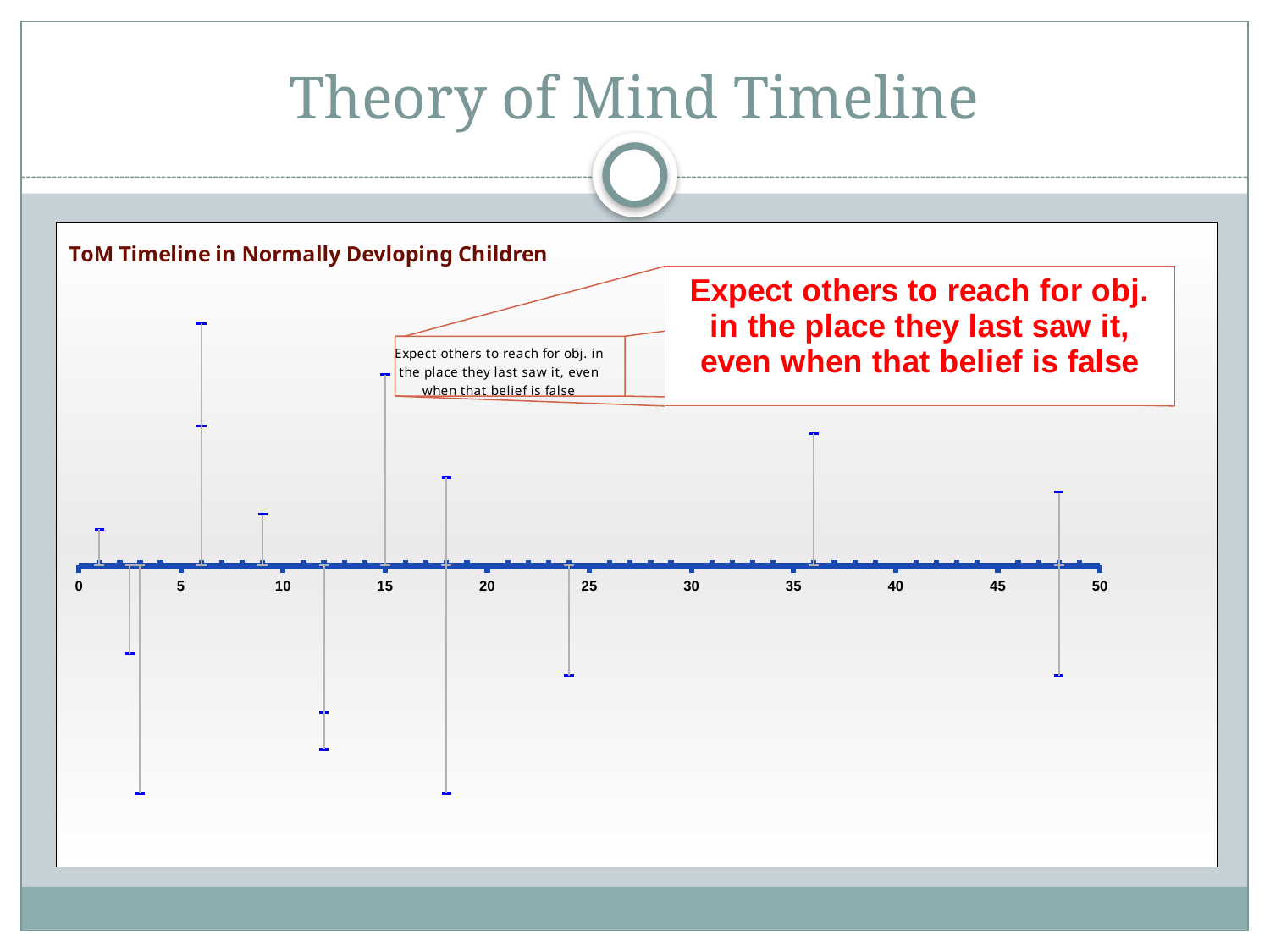
What is the title of the chart on the slide? ToM Timeline in Normally Devloping Children At what x-axis value is the event "Expect others to reach for obj. in the place they last saw it, even when that belief is false" plotted? 15 What is the highest value labelled on the chart's x axis? 50